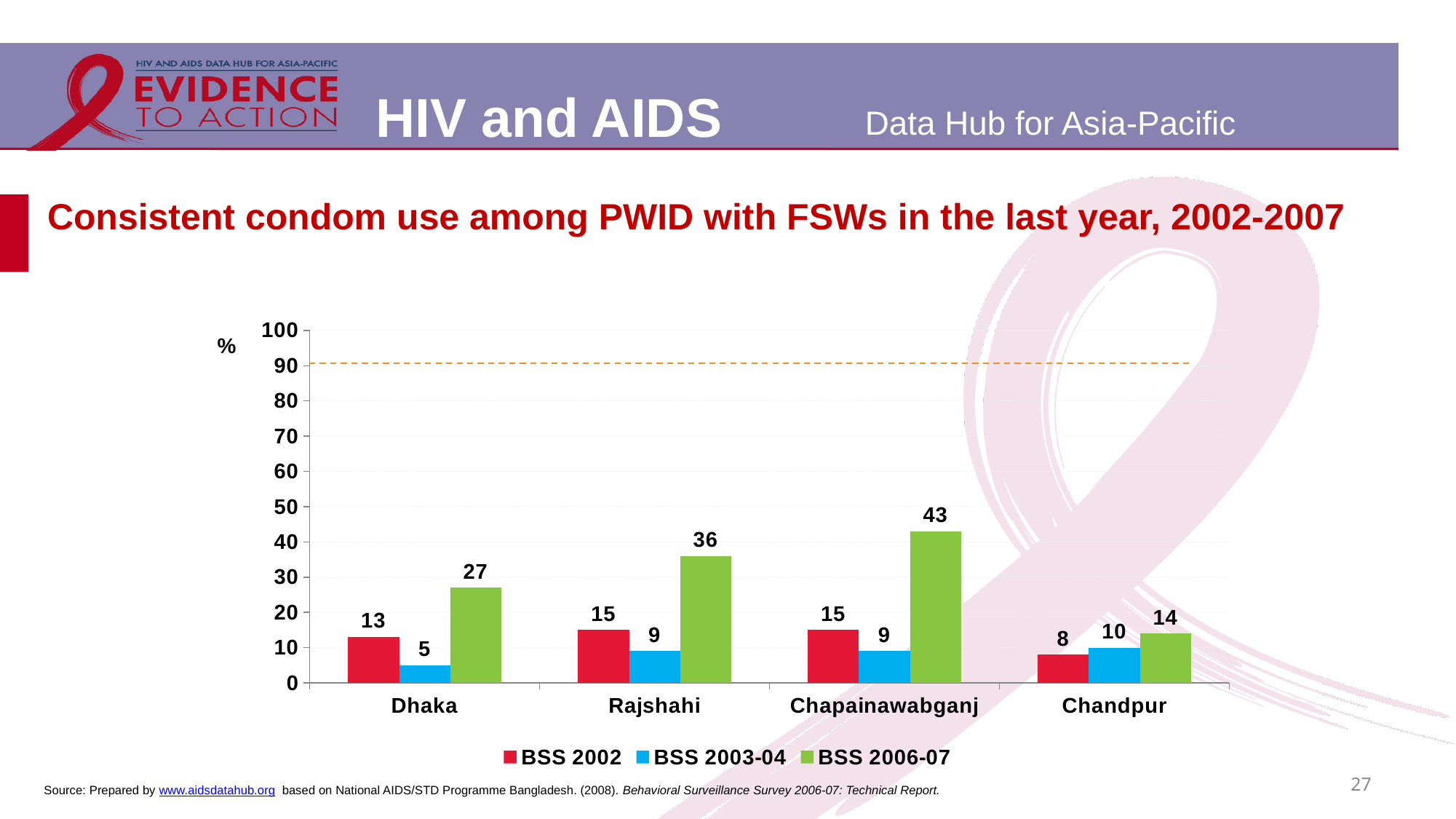
What kind of chart is shown on the slide? bar chart What is the BSS 2006-07 value for Chapainawabganj? 43 How many series does the legend list? 3 Which is larger for Chandpur: the BSS 2002 value or the BSS 2003-04 value? BSS 2003-04 What is the BSS 2002 value for Dhaka? 13 What is the title of the chart? Consistent condom use among PWID with FSWs in the last year, 2002-2007 What is the BSS 2003-04 value for Chandpur? 10 What is the difference between the BSS 2006-07 and BSS 2002 values for Rajshahi? 21 Which city has the lowest BSS 2003-04 value? Dhaka Which city has the highest BSS 2006-07 value? Chapainawabganj How many cities are shown on the x axis? 4 Is the BSS 2006-07 value for Rajshahi greater or less than 30? greater